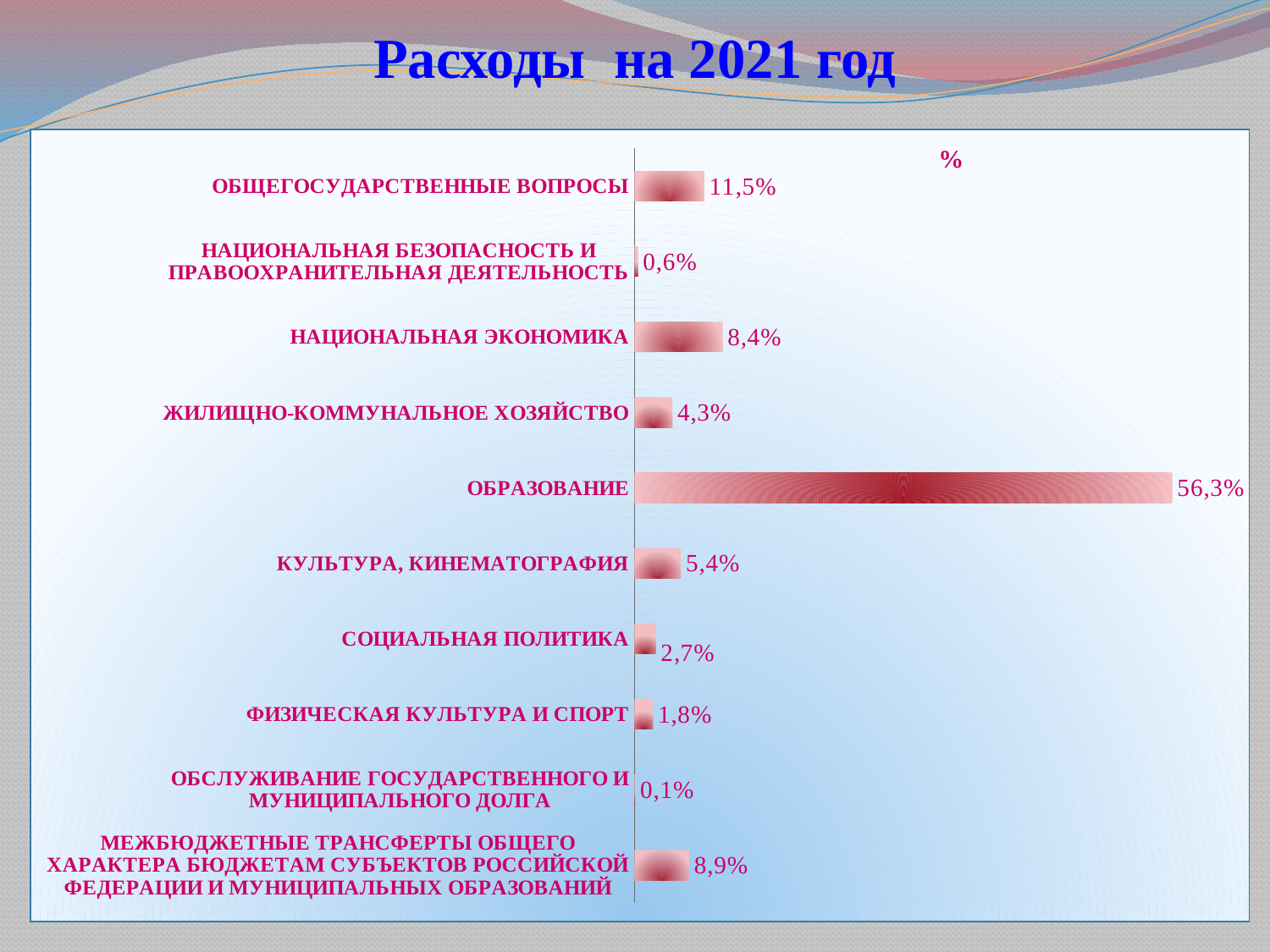
How many categories are shown in the chart? 10 What is the difference between the values for ОБЩЕГОСУДАРСТВЕННЫЕ ВОПРОСЫ and НАЦИОНАЛЬНАЯ ЭКОНОМИКА? 3,1% Which is larger, the value for НАЦИОНАЛЬНАЯ ЭКОНОМИКА or the value for КУЛЬТУРА, КИНЕМАТОГРАФИЯ? НАЦИОНАЛЬНАЯ ЭКОНОМИКА What is the value for ОБРАЗОВАНИЕ? 56,3% What is the value for ЖИЛИЩНО-КОММУНАЛЬНОЕ ХОЗЯЙСТВО? 4,3% What is the value for ФИЗИЧЕСКАЯ КУЛЬТУРА И СПОРТ? 1,8% What kind of chart is shown on the slide? Bar chart What is the value for ОБЩЕГОСУДАРСТВЕННЫЕ ВОПРОСЫ? 11,5% What is the title of the slide? Расходы на 2021 год Which category has the highest value? ОБРАЗОВАНИЕ Which category has the lowest value? ОБСЛУЖИВАНИЕ ГОСУДАРСТВЕННОГО И МУНИЦИПАЛЬНОГО ДОЛГА What is the difference between the values for ОБРАЗОВАНИЕ and ОБЩЕГОСУДАРСТВЕННЫЕ ВОПРОСЫ? 44,8%